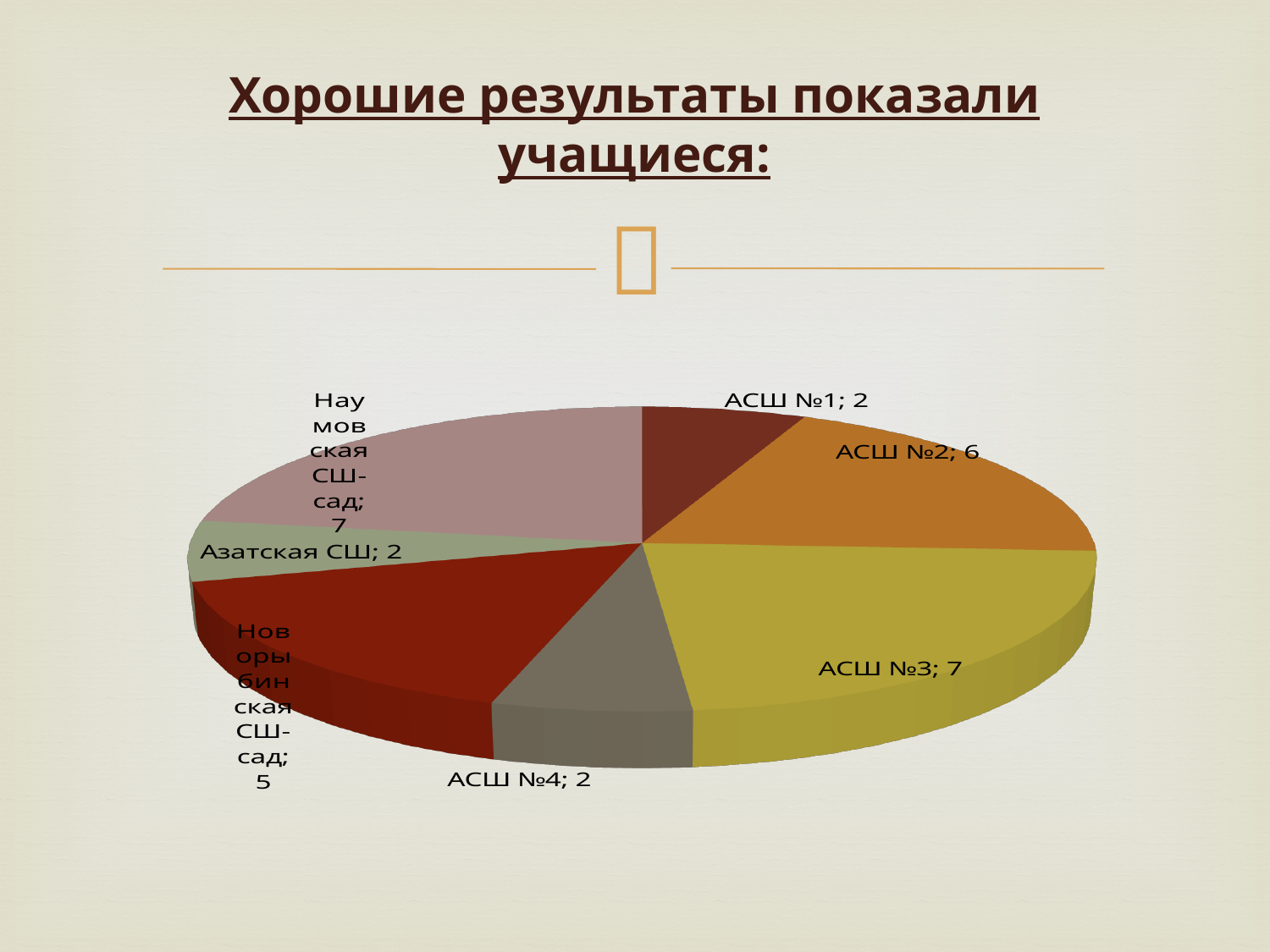
What value is shown for Наумовская СШ-сад in the pie chart? 7 How many categories (slices) does the pie chart have? 7 What is the difference between the values for АСШ №3 and АСШ №4? 5 What kind of chart is shown on the slide? Pie chart Which has the larger value, АСШ №2 or АСШ №1? АСШ №2 Which has the larger value, Наумовская СШ-сад or Новорыбинская СШ-сад? Наумовская СШ-сад What value is shown for АСШ №2 in the pie chart? 6 What value is shown for Новорыбинская СШ-сад in the pie chart? 5 What is the total of all the values shown in the pie chart? 31 What is the difference between the values for АСШ №2 and Новорыбинская СШ-сад? 1 What value is shown for Азатская СШ in the pie chart? 2 What value is shown for АСШ №3 in the pie chart? 7